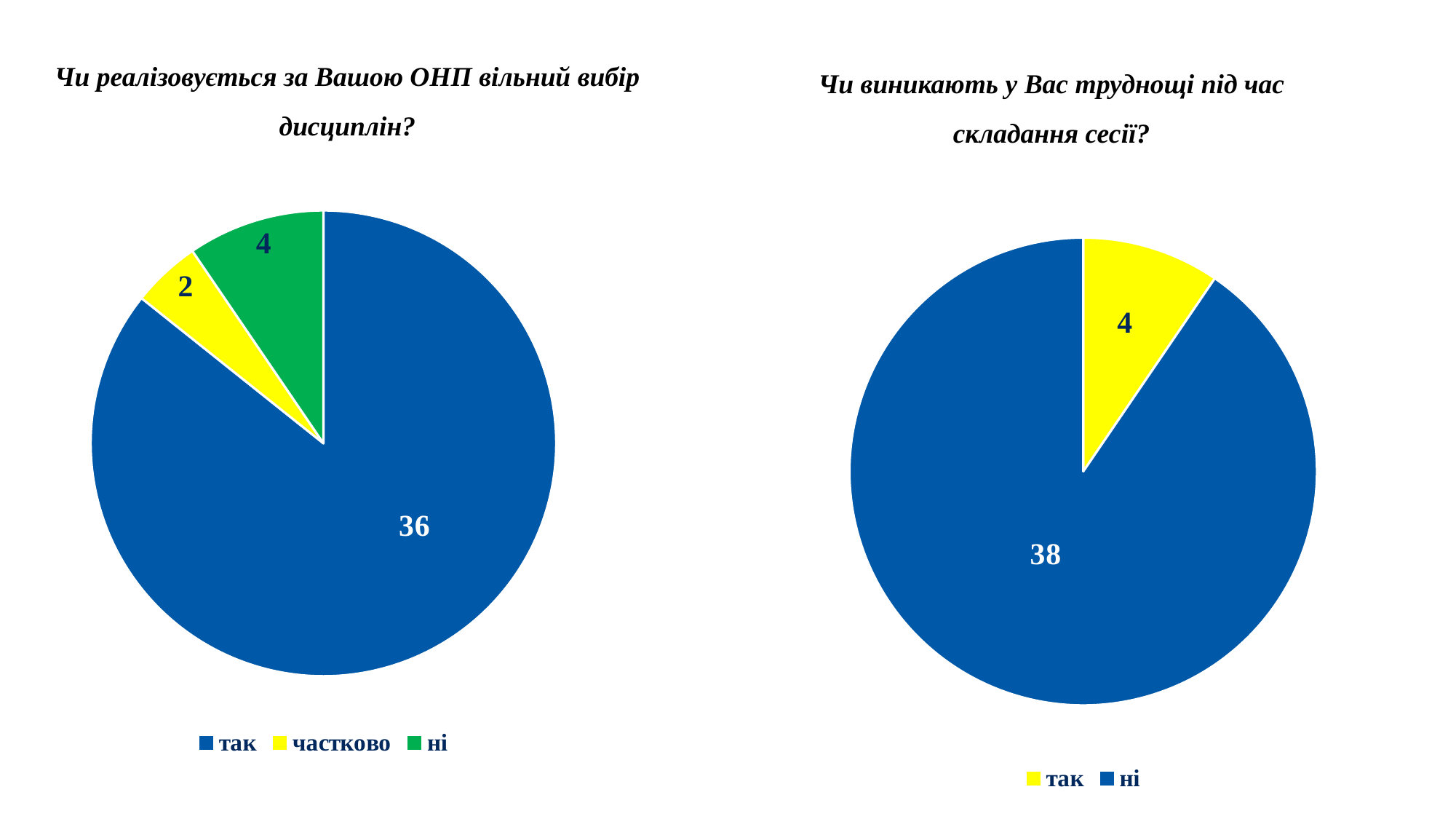
In the right chart, which category has the largest slice? ні In the right chart ("Чи виникають у Вас труднощі під час складання сесії?"), what is the value for "так"? 4 In the left chart, which category has the smallest slice? частково What type of chart is the right chart? Pie chart How many categories does the left chart's legend list? 3 In the left chart ("Чи реалізовується за Вашою ОНП вільний вибір дисциплін?"), what is the value for "ні"? 4 In the left chart, what is the difference between the values for "так" and "ні"? 32 In the left chart ("Чи реалізовується за Вашою ОНП вільний вибір дисциплін?"), what is the value for "частково"? 2 In the right chart ("Чи виникають у Вас труднощі під час складання сесії?"), what is the value for "ні"? 38 In the right chart, what is the difference between the values for "ні" and "так"? 34 In the left chart ("Чи реалізовується за Вашою ОНП вільний вибір дисциплін?"), what is the value for "так"? 36 In the left chart, which is larger: the value for "ні" or the value for "частково"? ні